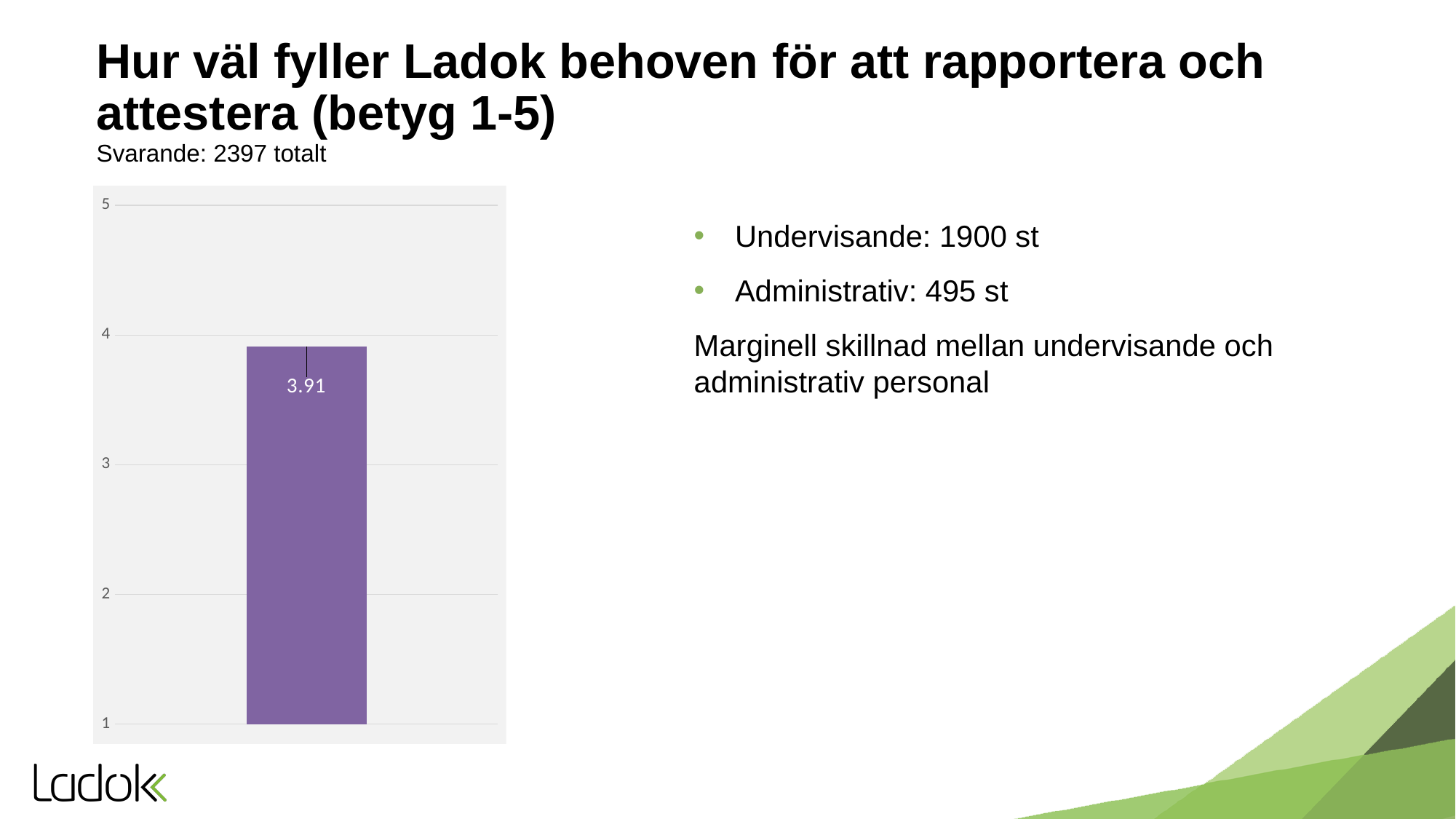
Is the value of the bar greater or less than 4? less What value is printed on the bar in the chart? 3.91 What is the lowest value shown on the chart's vertical axis? 1 What is the highest value shown on the chart's vertical axis? 5 What kind of chart is shown on the slide? bar chart How many bars are plotted in the chart? 1 Is the value of the bar greater or less than 3? greater